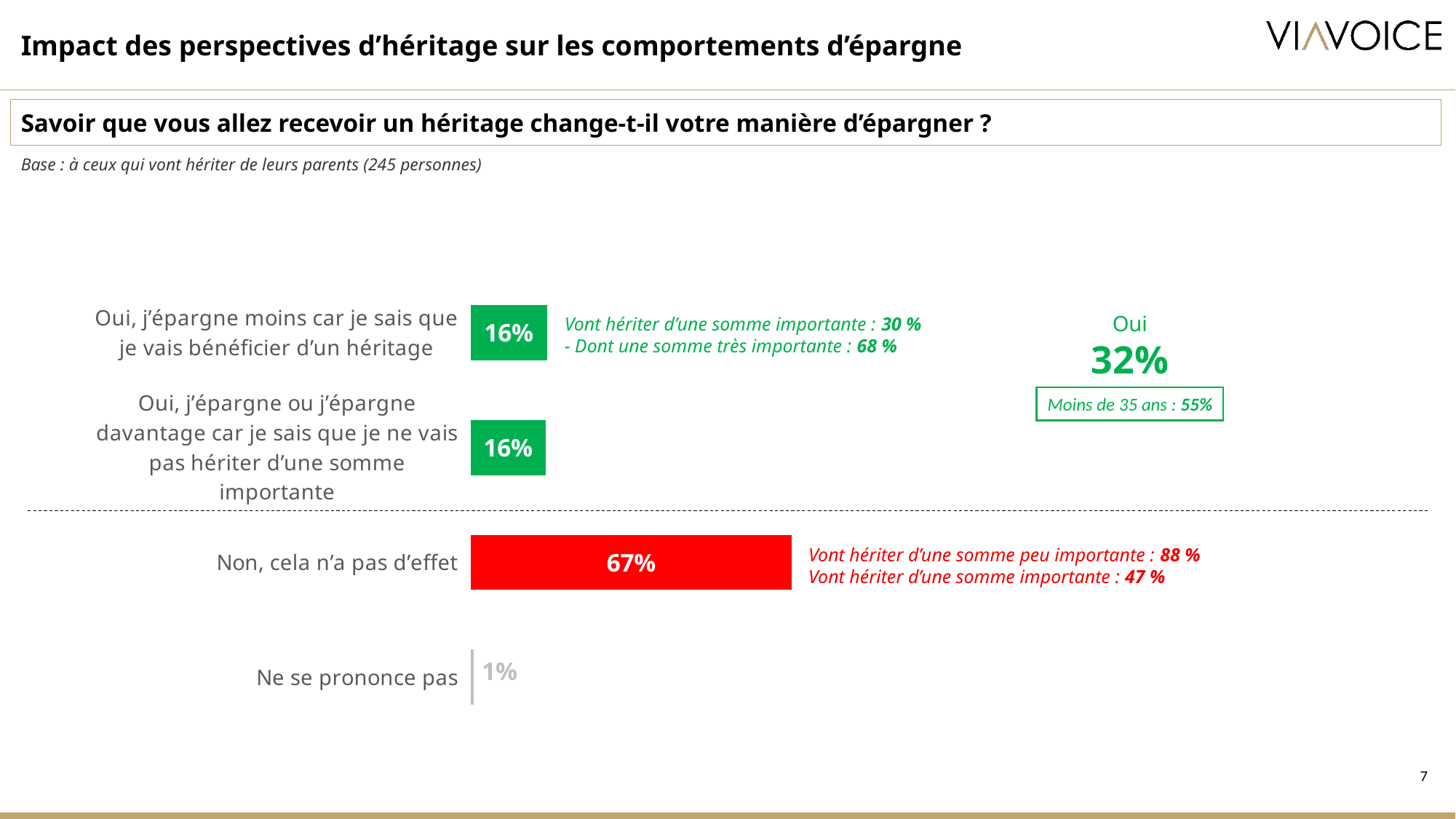
Which category has the lowest value? Ne se prononce pas What is the value for "Oui, j'épargne moins car je sais que je vais bénéficier d'un héritage"? 16% What is the combined total shown for the two "Oui" answers? 32% Which category has the highest value? Non, cela n'a pas d'effet What kind of chart is shown on the slide? Bar chart What is the value for "Non, cela n'a pas d'effet"? 67% What is the value for "Oui, j'épargne ou j'épargne davantage car je sais que je ne vais pas hériter d'une somme importante"? 16% What is the value for "Ne se prononce pas"? 1% Which is larger: the value for "Non, cela n'a pas d'effet" or the value for "Ne se prononce pas"? Non, cela n'a pas d'effet How many categories are shown in the chart? 4 What colour is the bar for "Non, cela n'a pas d'effet"? Red What is the difference between the value for "Non, cela n'a pas d'effet" and the value for "Oui, j'épargne moins car je sais que je vais bénéficier d'un héritage"? 51 percentage points